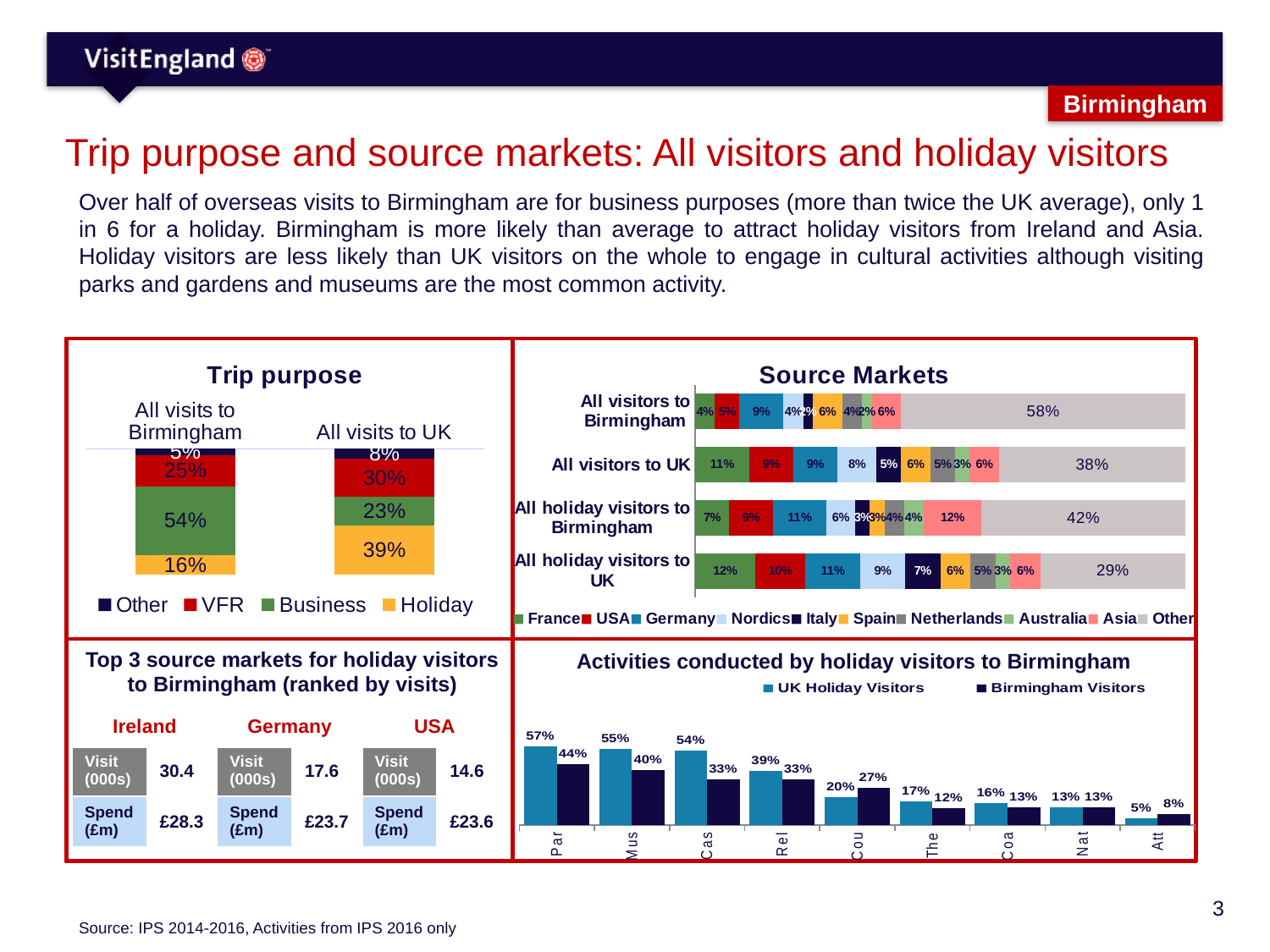
In the Source Markets chart, how many visitor groups (bars) are shown? 4 In the Source Markets chart, how many series does the legend list? 10 In the Activities conducted by holiday visitors to Birmingham chart, what is the UK Holiday Visitors value for the leftmost category? 57% In the Activities conducted by holiday visitors to Birmingham chart, what kind of chart is it? Bar chart In the Source Markets chart, which is larger: the Germany share for all holiday visitors to Birmingham or for all visitors to Birmingham? All holiday visitors to Birmingham In the Source Markets chart, what share of all visitors to Birmingham come from the 'Other' markets? 58% In the Trip purpose chart, what share of all visits to Birmingham are for business? 54% In the Trip purpose chart, what share of all visits to the UK are for a holiday? 39% In the Trip purpose chart, how many series does the legend list? 4 In the Activities conducted by holiday visitors to Birmingham chart, how many activity categories are shown? 9 In the Source Markets chart, what share of all holiday visitors to Birmingham come from Asia? 12% In the Trip purpose chart, what is the difference between the VFR share for all visits to the UK and for all visits to Birmingham? 5%